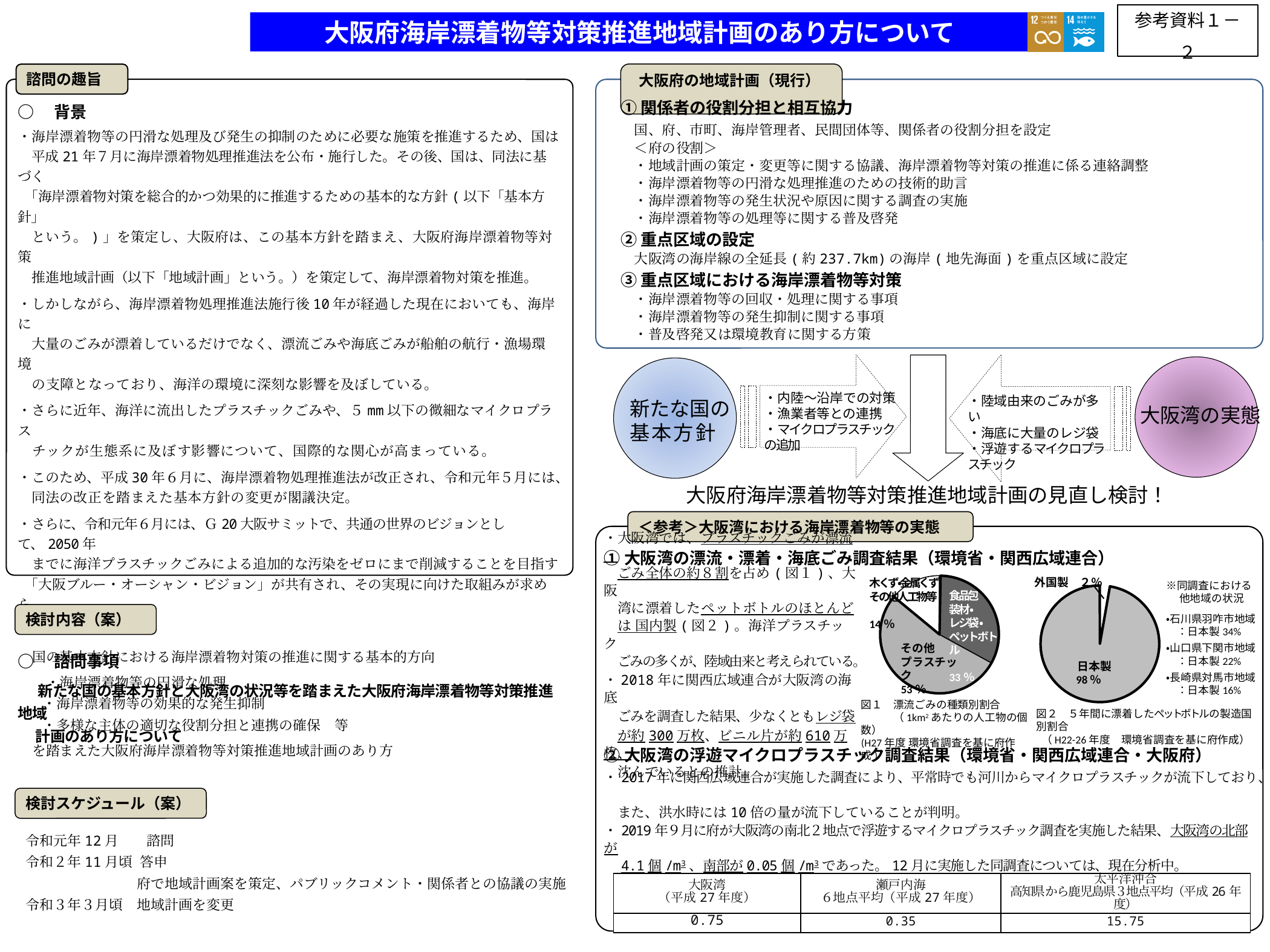
In 図1 (漂流ごみの種類別割合), how many percentage points larger is その他プラスチック than 食品包装材・レジ袋・ペットボトル? 20 In 図1 (漂流ごみの種類別割合), which category has the smallest share? 木くず・金属くず・その他人工物等 In 図1 (漂流ごみの種類別割合), what share is 木くず・金属くず・その他人工物等? 14％ How many slices does 図2 (5年間に漂着したペットボトルの製造国別割合) have? 2 In 図1 (漂流ごみの種類別割合), which category has the largest share? その他プラスチック How many slices does 図1 (漂流ごみの種類別割合) have? 3 What kind of chart is 図1 (漂流ごみの種類別割合)? pie chart In 図2 (5年間に漂着したペットボトルの製造国別割合), what share is 日本製? 98％ In 図1 (漂流ごみの種類別割合), what share is その他プラスチック? 53％ In 図2 (5年間に漂着したペットボトルの製造国別割合), which is larger, 日本製 or 外国製? 日本製 In 図1 (漂流ごみの種類別割合), what share is 食品包装材・レジ袋・ペットボトル? 33％ In 図2 (5年間に漂着したペットボトルの製造国別割合), what share is 外国製? 2％